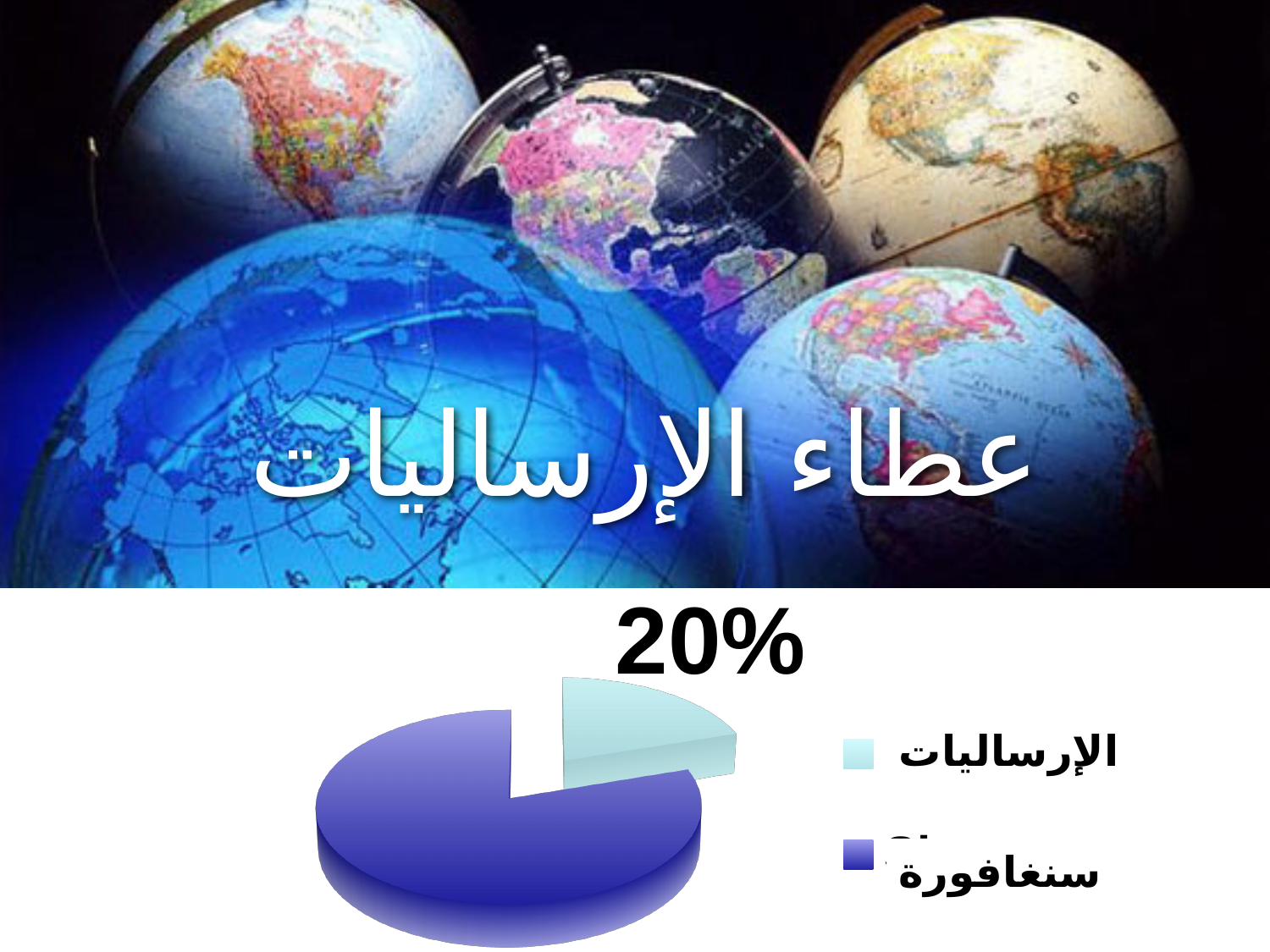
Which slice of the pie chart is larger, الإرساليات or سنغافورة? سنغافورة How many entries does the legend of the pie chart list? 2 Which category has the largest slice in the pie chart? سنغافورة What share of the pie does the الإرساليات slice represent? 20% How many slices does the pie chart have? 2 Is the share for الإرساليات greater or less than 50%? less What kind of chart is shown on the slide? pie chart Which category has the smallest slice in the pie chart? الإرساليات What are the two legend entries of the pie chart? الإرساليات and سنغافورة What percentage is labelled on the pie chart for الإرساليات? 20% What colour is the الإرساليات slice in the pie chart? light blue